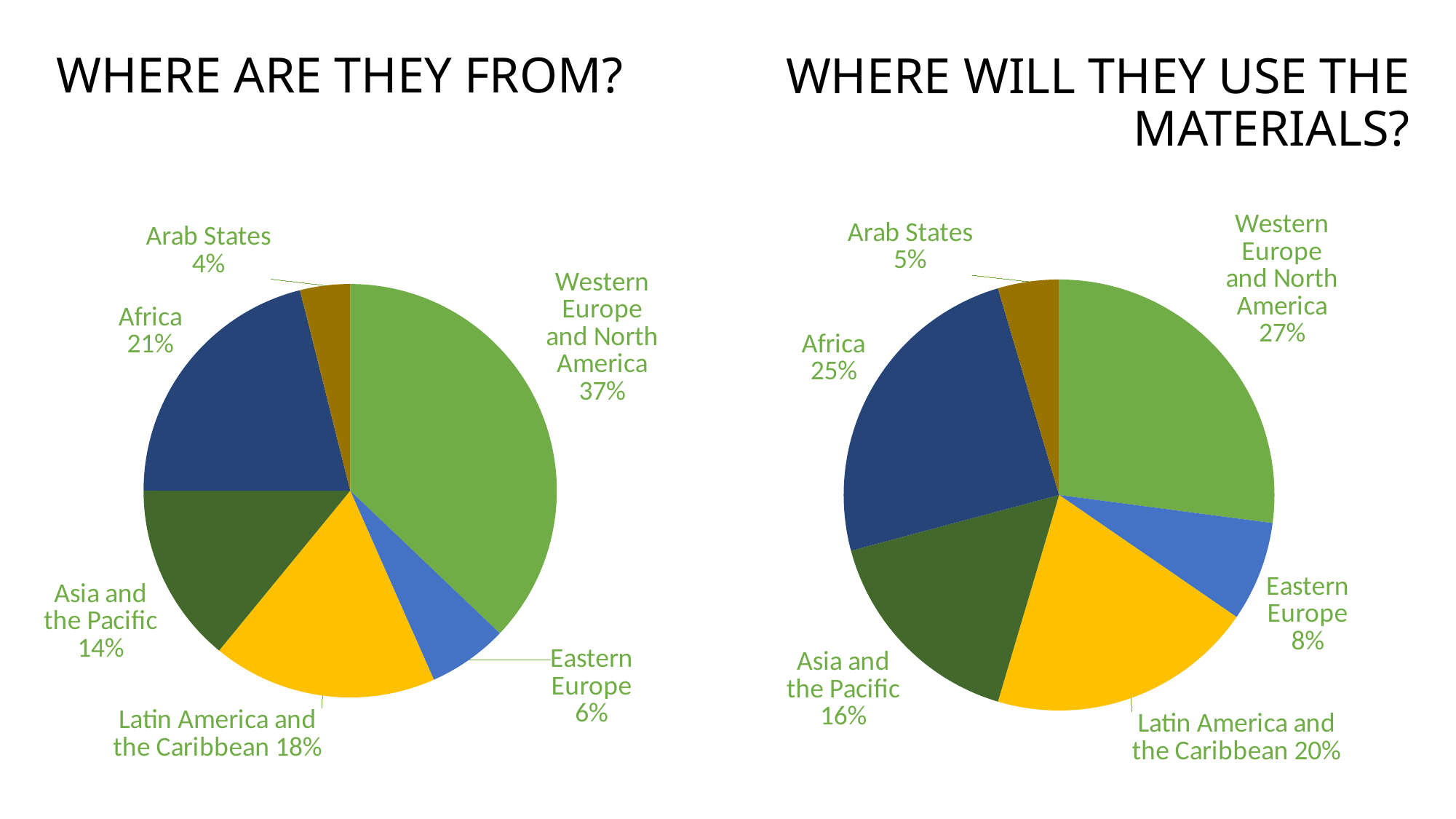
In the 'Where are they from?' chart, what share is Western Europe and North America? 37% In the 'Where will they use the materials?' chart, what is the difference between Western Europe and North America and Arab States? 22% What is the title of the chart on the right side of the slide? WHERE WILL THEY USE THE MATERIALS? In the 'Where are they from?' chart, what share is Latin America and the Caribbean? 18% In the 'Where will they use the materials?' chart, which is larger: Latin America and the Caribbean or Asia and the Pacific? Latin America and the Caribbean In the 'Where are they from?' chart, what is the difference between Africa and Asia and the Pacific? 7% In the 'Where will they use the materials?' chart, what share is Eastern Europe? 8% In the 'Where will they use the materials?' chart, which region has the largest slice? Western Europe and North America What type of chart is used on the left side of the slide? Pie chart In the 'Where will they use the materials?' chart, what share is Africa? 25% In the 'Where are they from?' chart, which region has the smallest slice? Arab States How many slices does the 'Where are they from?' pie chart have? 6